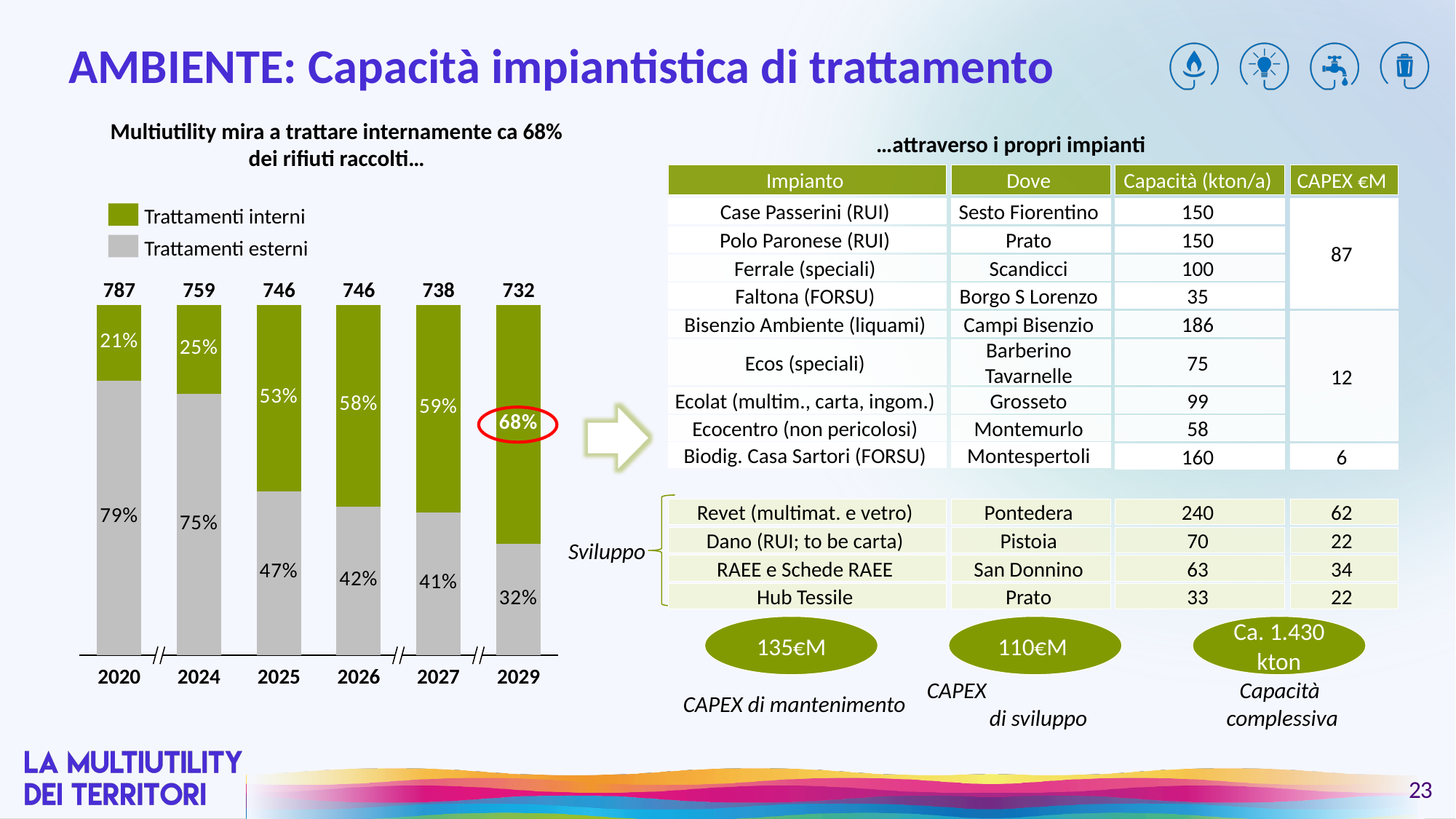
What is the Trattamenti esterni share for 2020? 79% What is the difference between the Trattamenti interni share in 2029 and in 2020? 47 percentage points Is the Trattamenti esterni share larger in 2025 or in 2027? 2025 Do the totals printed above the bars rise or fall from 2020 to 2029? fall Which year has the lowest Trattamenti interni share? 2020 Which colour represents Trattamenti interni in the chart? green How many years are shown on the x axis of the chart? 6 What total value is printed above the bar for 2024? 759 What type of chart is shown on the left of the slide? stacked bar chart Which year has the highest total printed above its bar? 2020 How many series does the chart legend list? 2 What is the Trattamenti interni share for 2029? 68%